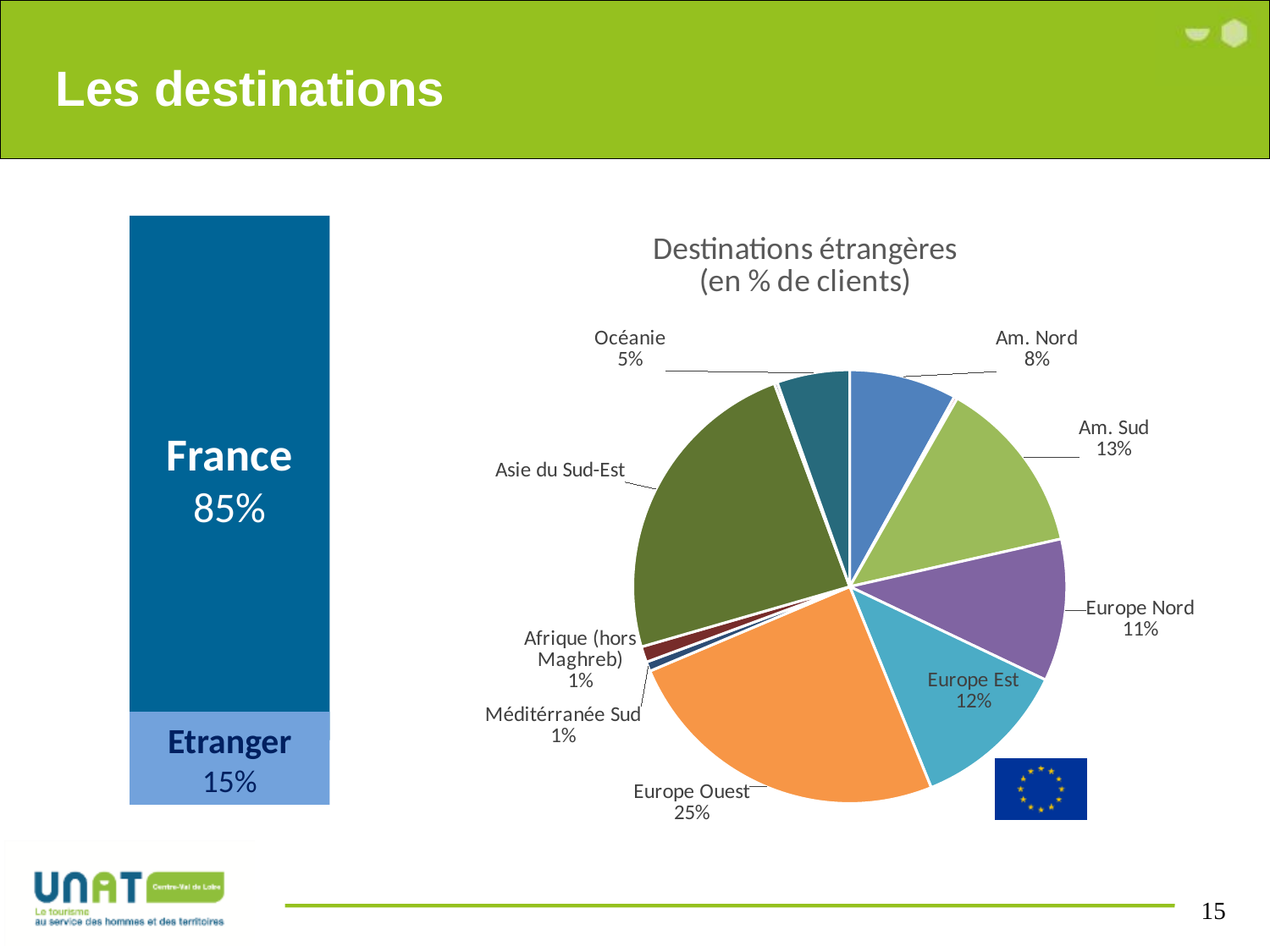
In the left bar chart, what percentage is shown for Etranger? 15% What kind of chart is the chart on the right of the slide? Pie chart In the pie chart 'Destinations étrangères', what share is shown for Am. Sud? 13% In the pie chart 'Destinations étrangères', which has the larger share, Am. Sud or Europe Nord? Am. Sud In the pie chart 'Destinations étrangères', which has the larger share, Europe Est or Am. Nord? Europe Est In the pie chart 'Destinations étrangères', what share is shown for Afrique (hors Maghreb)? 1% In the left bar chart, what is the difference between the France and Etranger percentages? 70 percentage points In the pie chart 'Destinations étrangères', what share is shown for Océanie? 5% In the pie chart 'Destinations étrangères', what is the difference between the shares of Europe Ouest and Europe Est? 13 percentage points In the left bar chart, what percentage is shown for France? 85% In the pie chart 'Destinations étrangères', what share is shown for Europe Ouest? 25%